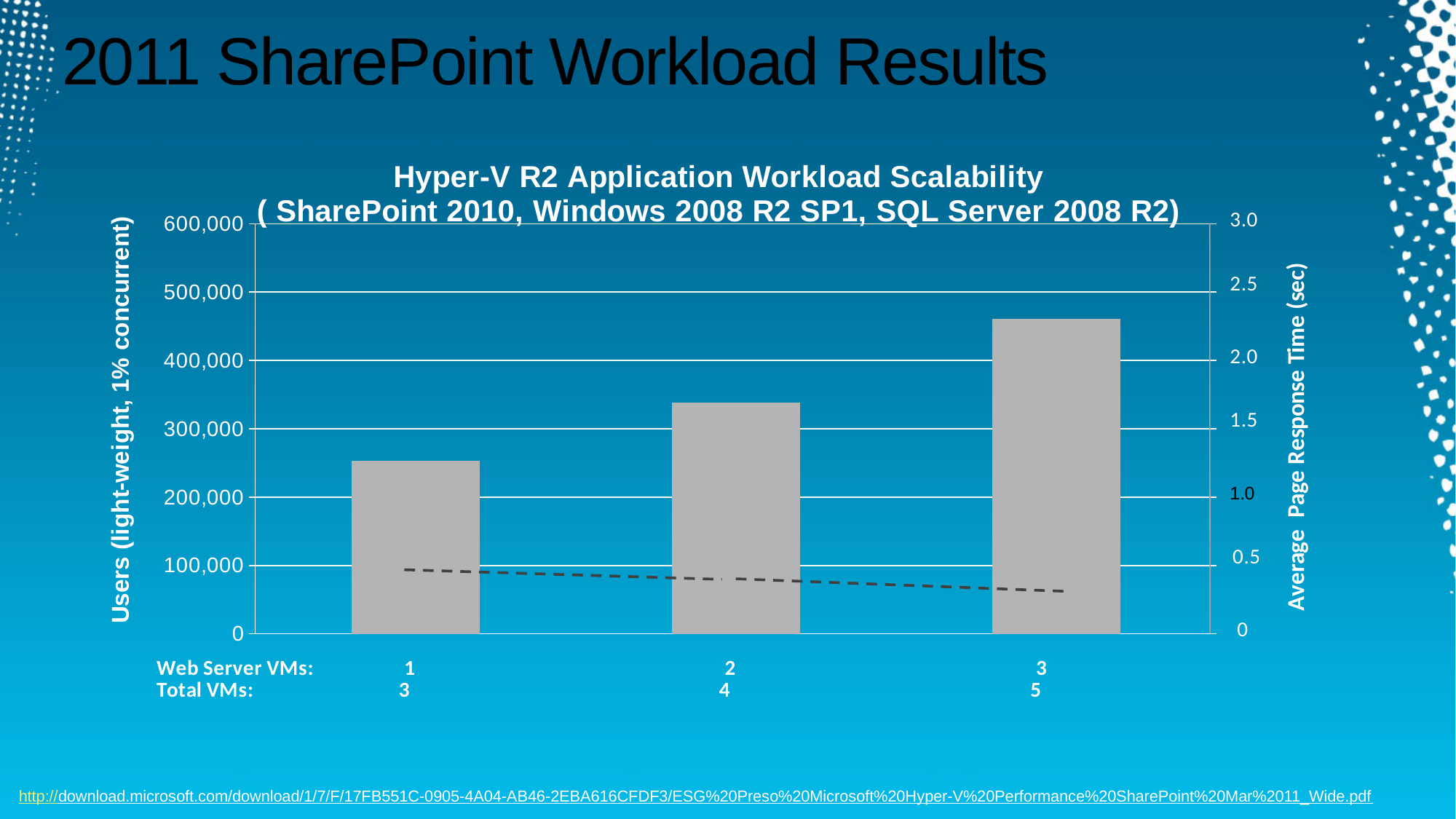
Is the average page response time for 1 Web Server VM greater or less than 0.5 seconds? less Is the number of users for 3 Web Server VMs greater or less than 500,000? less Which Web Server VMs configuration has the highest number of users? 3 How many bars are plotted in the chart? 3 Does the dashed average page response time line rise or fall as the number of Web Server VMs increases? fall Which Web Server VMs configuration has the lowest number of users? 1 Is the number of users for 1 Web Server VM greater or less than 300,000? less What kind of chart is shown on the slide? bar chart with a line What is the label of the right-hand vertical axis? Average Page Response Time (sec) Which has more users: 2 Web Server VMs or 3 Web Server VMs? 3 Web Server VMs Do the user bars rise or fall as the number of Web Server VMs increases? rise